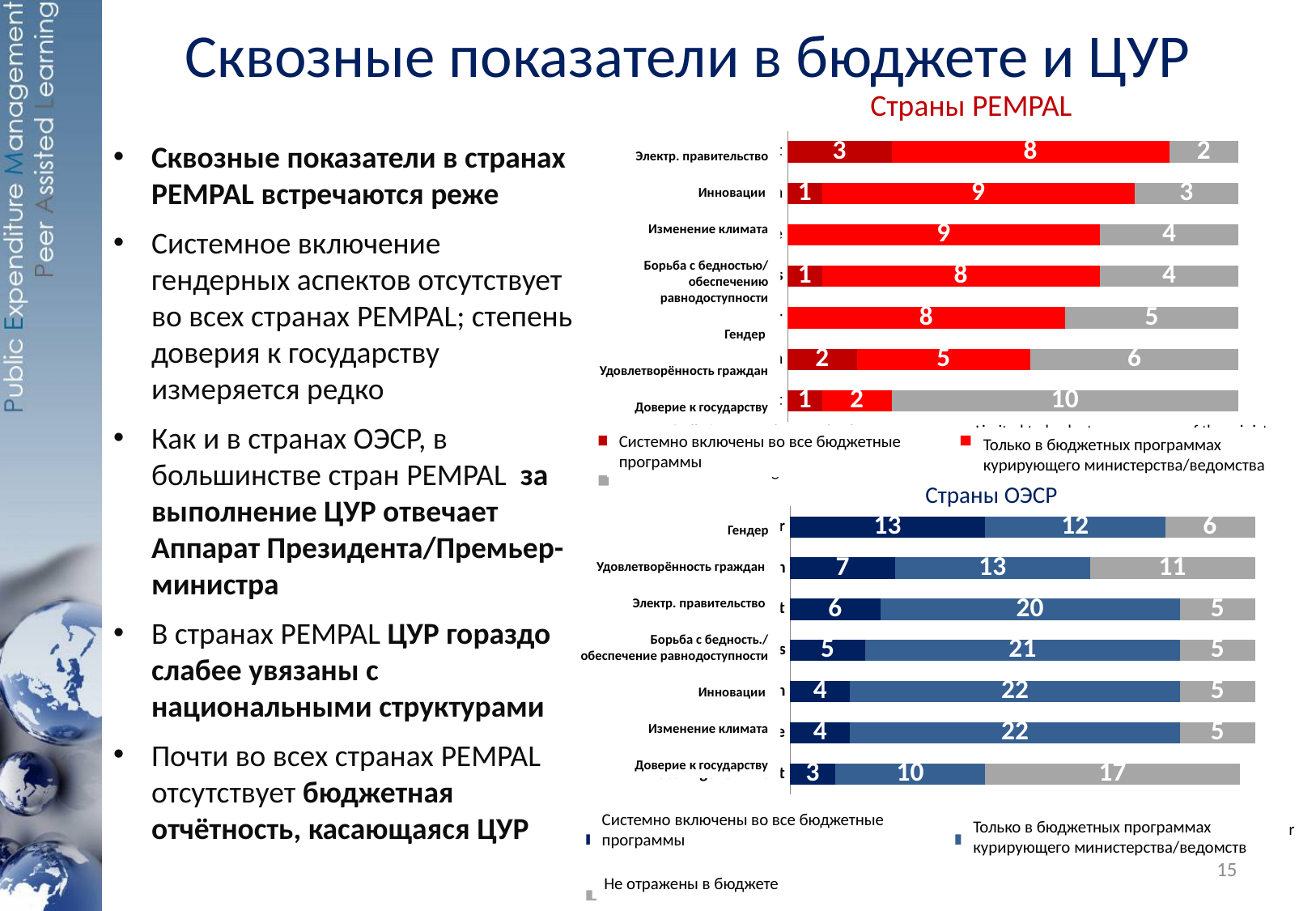
In the 'Страны ОЭСР' chart, which category has the largest 'Не отражены в бюджете' segment? Доверие к государству In the 'Страны ОЭСР' chart, which is larger: the 'Системно включены во все бюджетные программы' value for 'Удовлетворённость граждан' or for 'Электр. правительство'? Удовлетворённость граждан In the 'Страны PEMPAL' chart, which category has the largest 'Системно включены во все бюджетные программы' segment? Электр. правительство What kind of chart is the 'Страны PEMPAL' chart? Stacked bar chart In the 'Страны PEMPAL' chart, what is the value of the grey 'Не отражены в бюджете' segment for 'Доверие к государству'? 10 How many categories are shown in the 'Страны ОЭСР' chart? 7 How many series does the legend of the 'Страны ОЭСР' chart list? 3 In the 'Страны ОЭСР' chart, what is the difference between the 'Только в бюджетных программах курирующего министерства/ведомств' values for 'Инновации' and 'Гендер'? 10 In the 'Страны PEMPAL' chart, what is the total of the stacked bar for 'Удовлетворённость граждан'? 13 In the 'Страны ОЭСР' chart, what is the value of the 'Системно включены во все бюджетные программы' segment for 'Гендер'? 13 In the 'Страны PEMPAL' chart, what is the value of the 'Только в бюджетных программах курирующего министерства/ведомства' segment for 'Инновации'? 9 In the 'Страны ОЭСР' chart, what is the total of the stacked bar for 'Доверие к государству'? 30